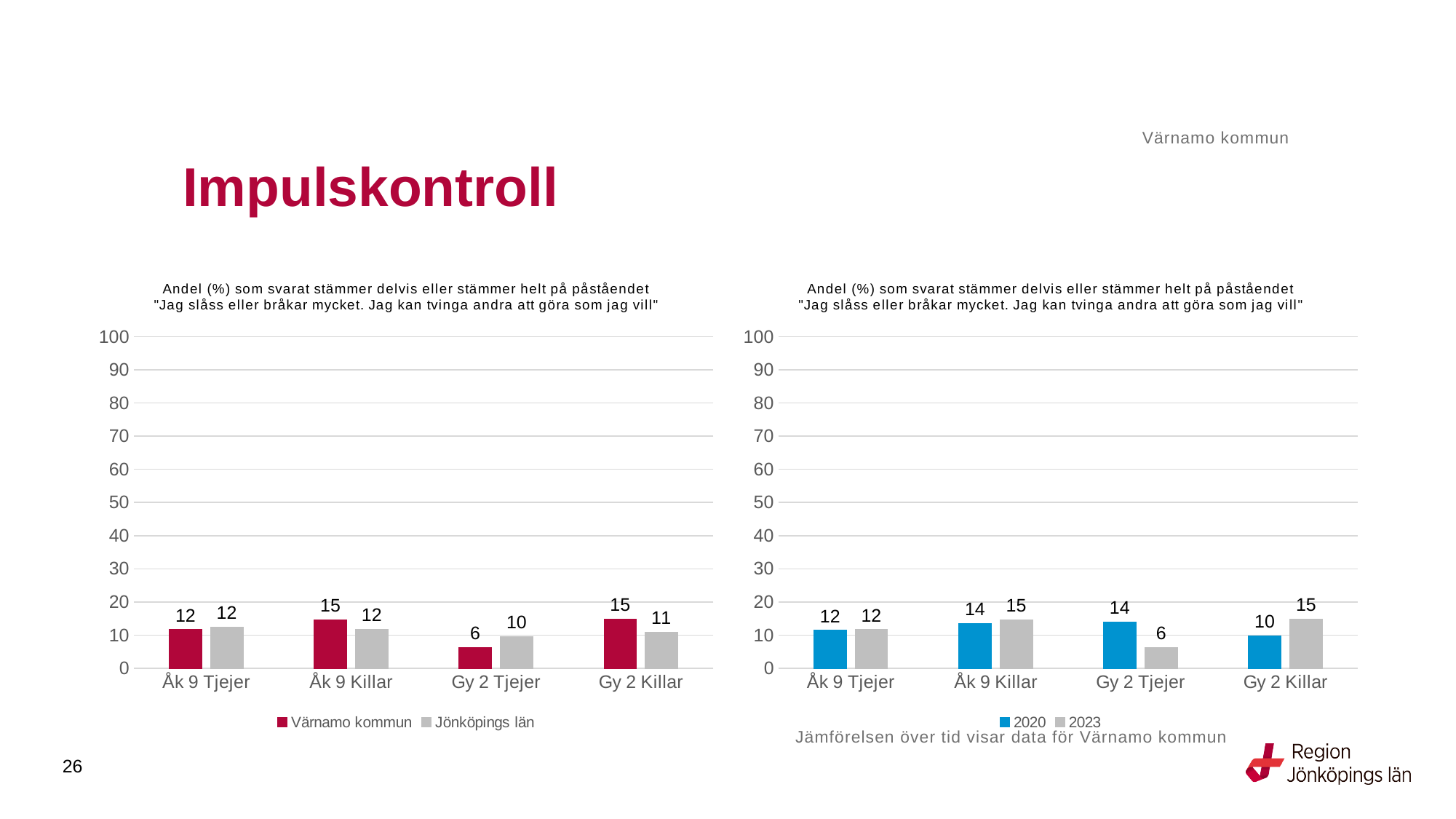
What kind of chart is the right chart? Bar chart In the left chart, which is larger for Gy 2 Tjejer: Värnamo kommun or Jönköpings län? Jönköpings län In the right chart, what is the value for 2023 for Gy 2 Killar? 15 In the right chart, what is the value for 2020 for Gy 2 Tjejer? 14 How many series does the legend of the left chart list? 2 In the right chart, what is the difference between 2020 and 2023 for Gy 2 Tjejer? 8 In the left chart, what is the value for Jönköpings län for Gy 2 Killar? 11 In the left chart, which category has the lowest value for Värnamo kommun? Gy 2 Tjejer In the left chart, what is the difference between Värnamo kommun and Jönköpings län for Gy 2 Killar? 4 In the left chart, what is the value for Värnamo kommun for Gy 2 Tjejer? 6 How many categories are shown on the x axis of the right chart? 4 In the right chart, which is larger for Gy 2 Killar: 2020 or 2023? 2023